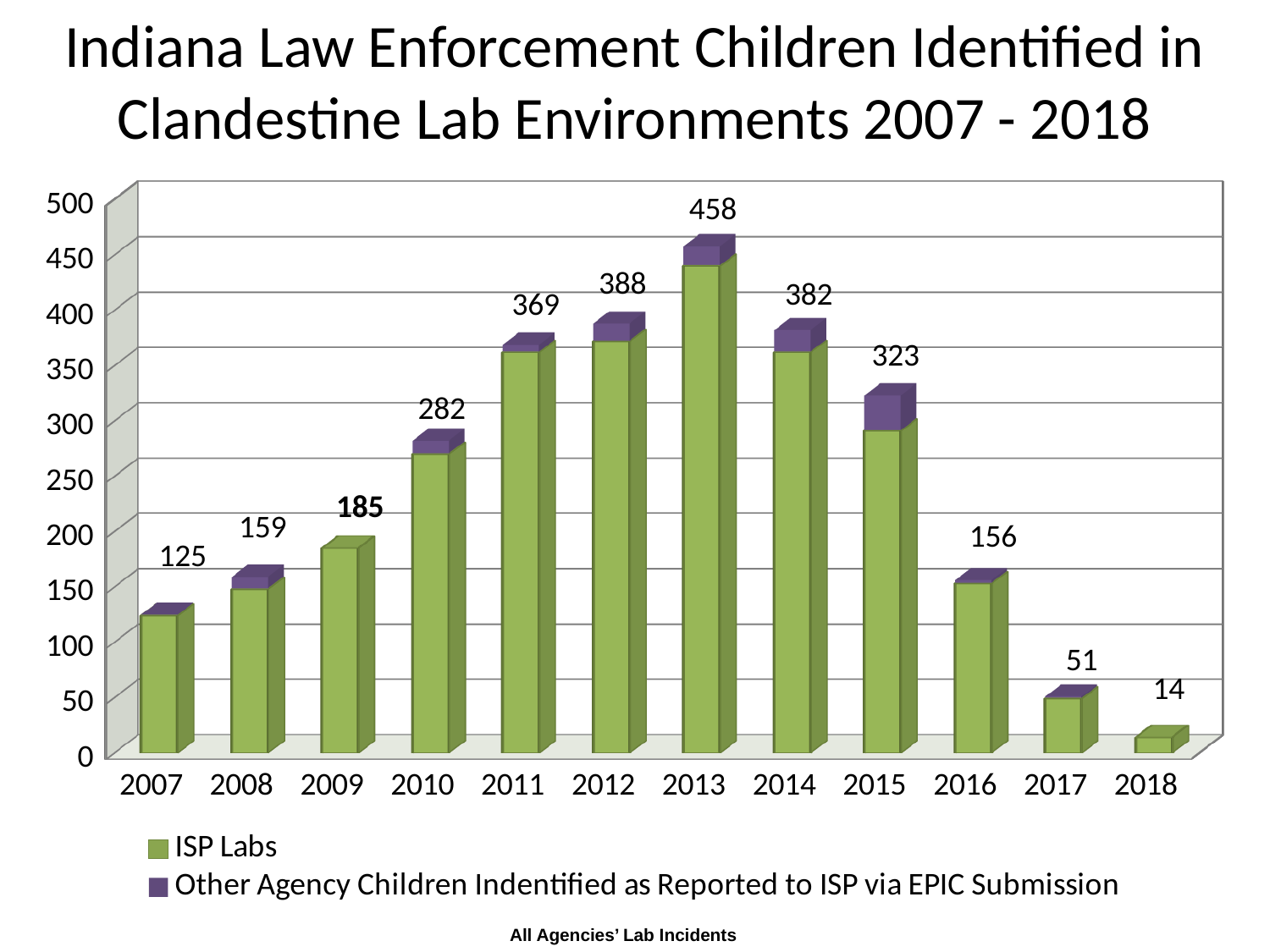
What is the total number of children identified in 2007? 125 Which year has a larger total, 2011 or 2015? 2011 Do the totals rise or fall from 2013 to 2018? Fall Which year has the lowest total number of children identified? 2018 Is the ISP Labs value for 2013 greater or less than 400? greater What kind of chart is shown on the slide? Stacked bar chart What is the difference between the totals for 2013 and 2014? 76 How many years are shown on the x axis? 12 How many series does the legend list? 2 What is the total number of children identified in 2013? 458 Which year has the highest total number of children identified? 2013 What is the total number of children identified in 2018? 14